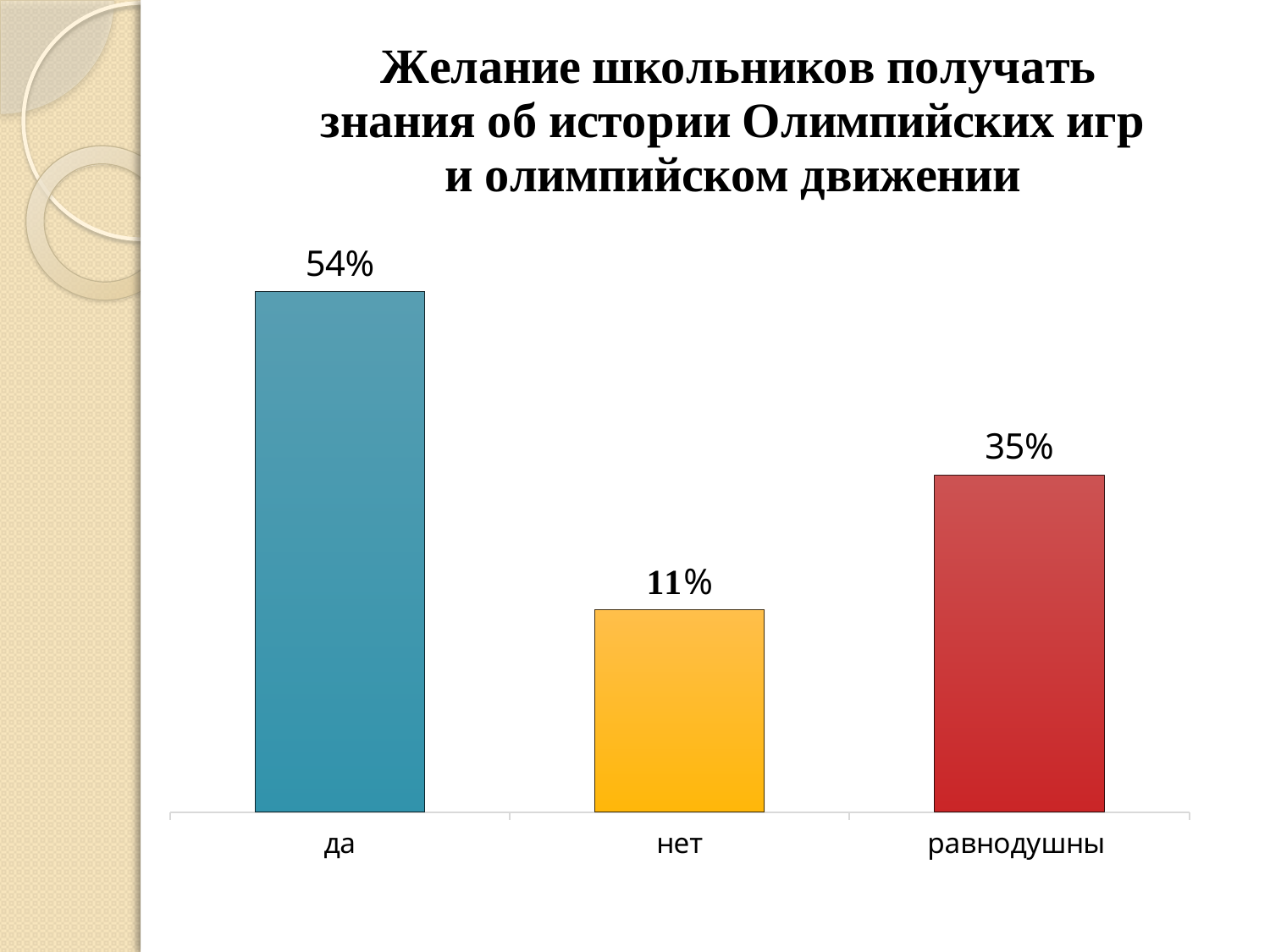
How many categories are shown in the chart? 3 What colour is the bar for "нет"? yellow What kind of chart is shown on the slide? bar chart What is the value for "нет"? 11% What is the value for "да"? 54% What is the difference between the values for "равнодушны" and "нет"? 24% Which is larger, the value for "нет" or the value for "равнодушны"? равнодушны What is the difference between the values for "да" and "равнодушны"? 19% What is the value for "равнодушны"? 35% Which category has the lowest value? нет Which category has the highest value? да What is the title of the chart? Желание школьников получать знания об истории Олимпийских игр и олимпийском движении